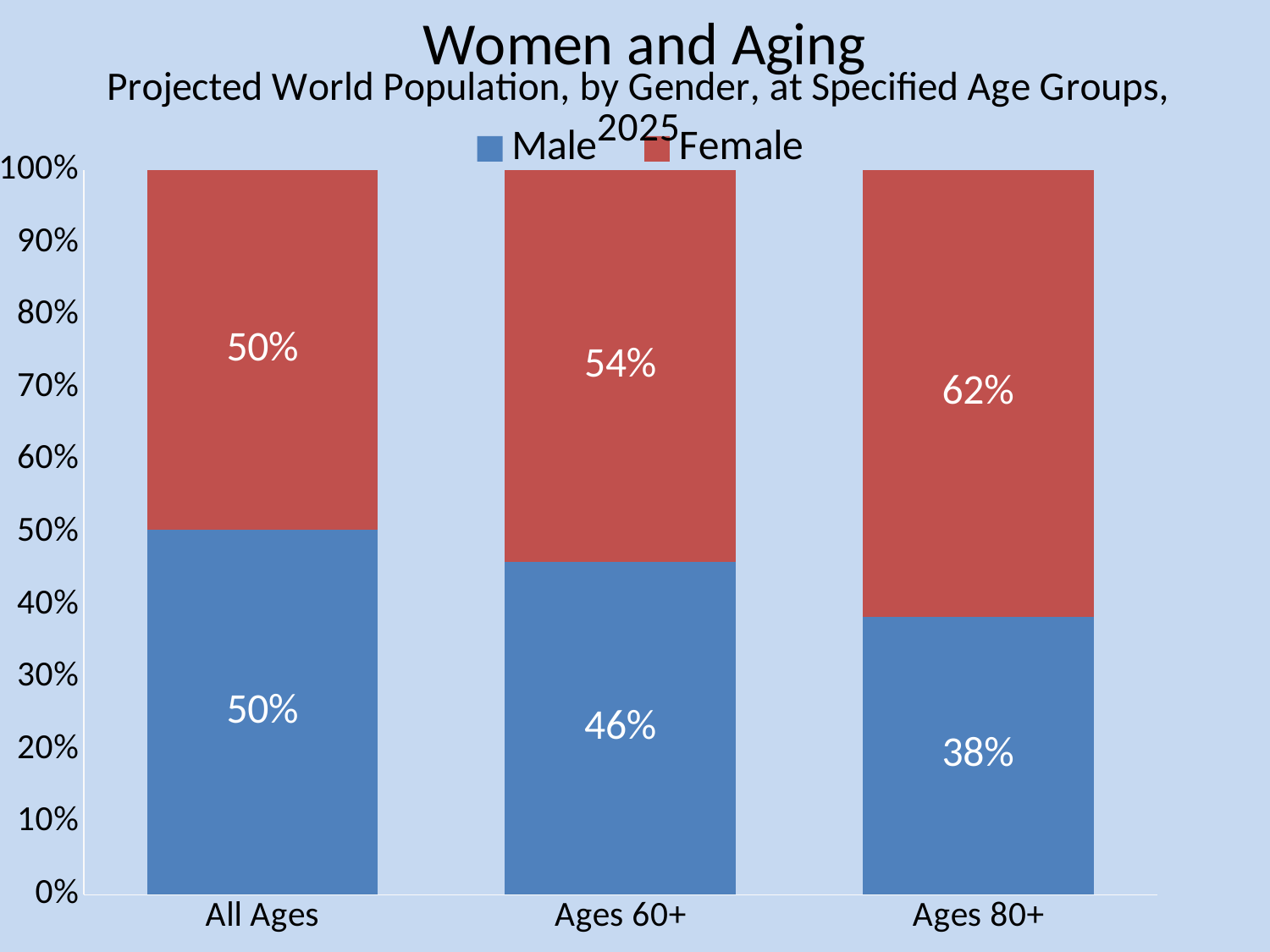
Does the Male share rise or fall from All Ages to Ages 80+? Fall How many age groups are shown on the x axis? 3 Which colour represents Female in the chart? Red What is the Male value for All Ages? 50% What is the Male value for Ages 60+? 46% Which is larger for Ages 60+, the Male value or the Female value? Female Which age group has the highest Female share? Ages 80+ What is the difference between the Female and Male values for Ages 80+? 24% How many series does the legend list? 2 What is the Female value for Ages 80+? 62% Which age group has the lowest Male share? Ages 80+ What kind of chart is shown on the slide? Stacked bar chart